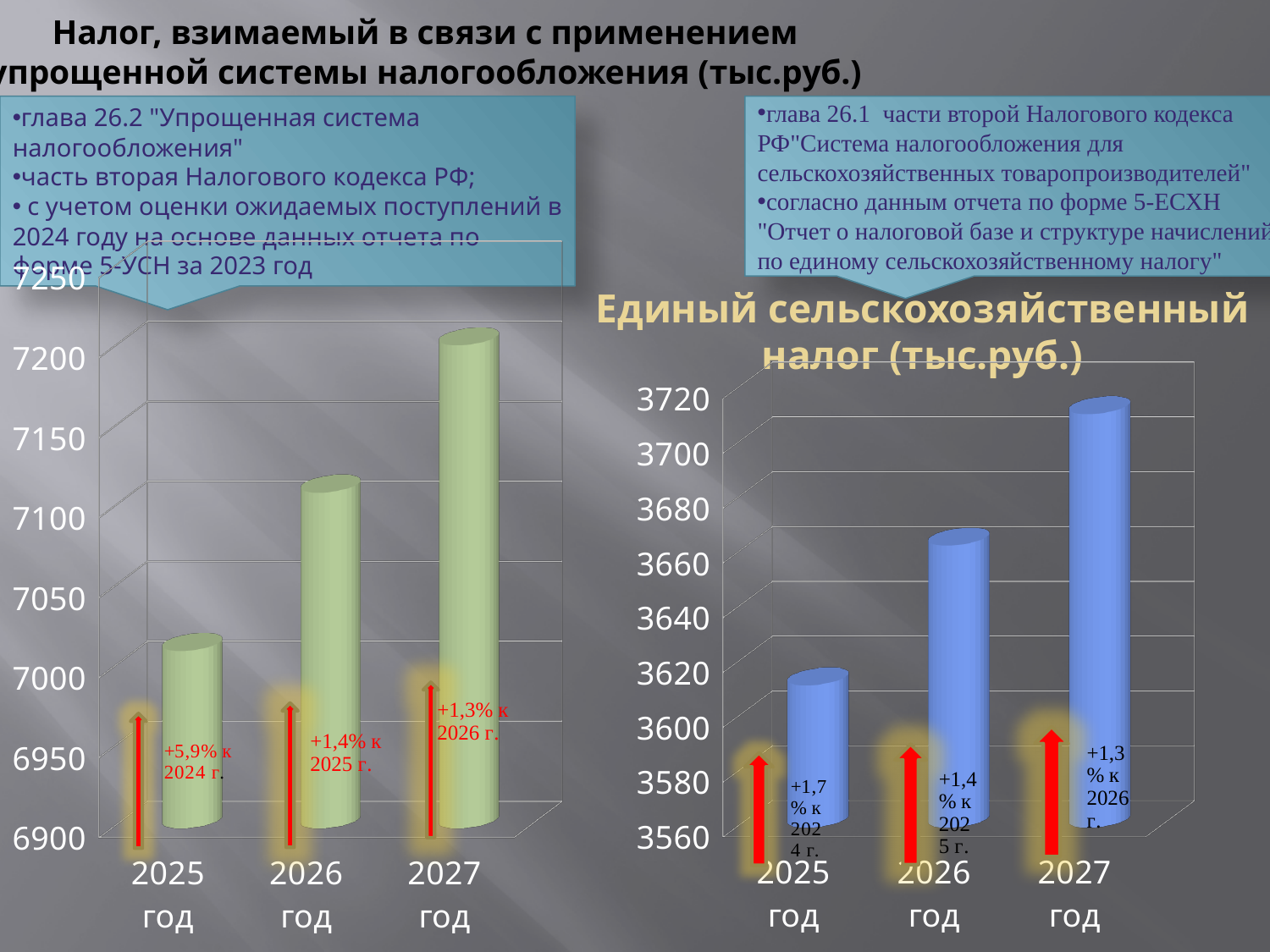
What kind of chart is the right chart titled "Единый сельскохозяйственный налог (тыс.руб.)"? bar chart In the left chart (simplified taxation system tax), do the values rise or fall from 2025 to 2027? rise What kind of chart is the left chart on the slide (the one about the simplified taxation system tax)? bar chart In the left chart (simplified taxation system tax), is the value for 2026 год greater or less than 7150? less In the right chart "Единый сельскохозяйственный налог (тыс.руб.)", which year has the highest value? 2027 год In the left chart (simplified taxation system tax), which year has the highest bar? 2027 год In the right chart "Единый сельскохозяйственный налог (тыс.руб.)", is the value for 2025 год greater or less than 3600? greater In the left chart (simplified taxation system tax), what percentage change label is shown next to the 2025 bar? +5,9% к 2024 г. In the left chart (simplified taxation system tax), which year has the lowest bar? 2025 год In the right chart "Единый сельскохозяйственный налог (тыс.руб.)", how many bars are plotted? 3 In the left chart (simplified taxation system tax), how many years are shown on the x axis? 3 In the right chart "Единый сельскохозяйственный налог (тыс.руб.)", which year has the lowest value? 2025 год